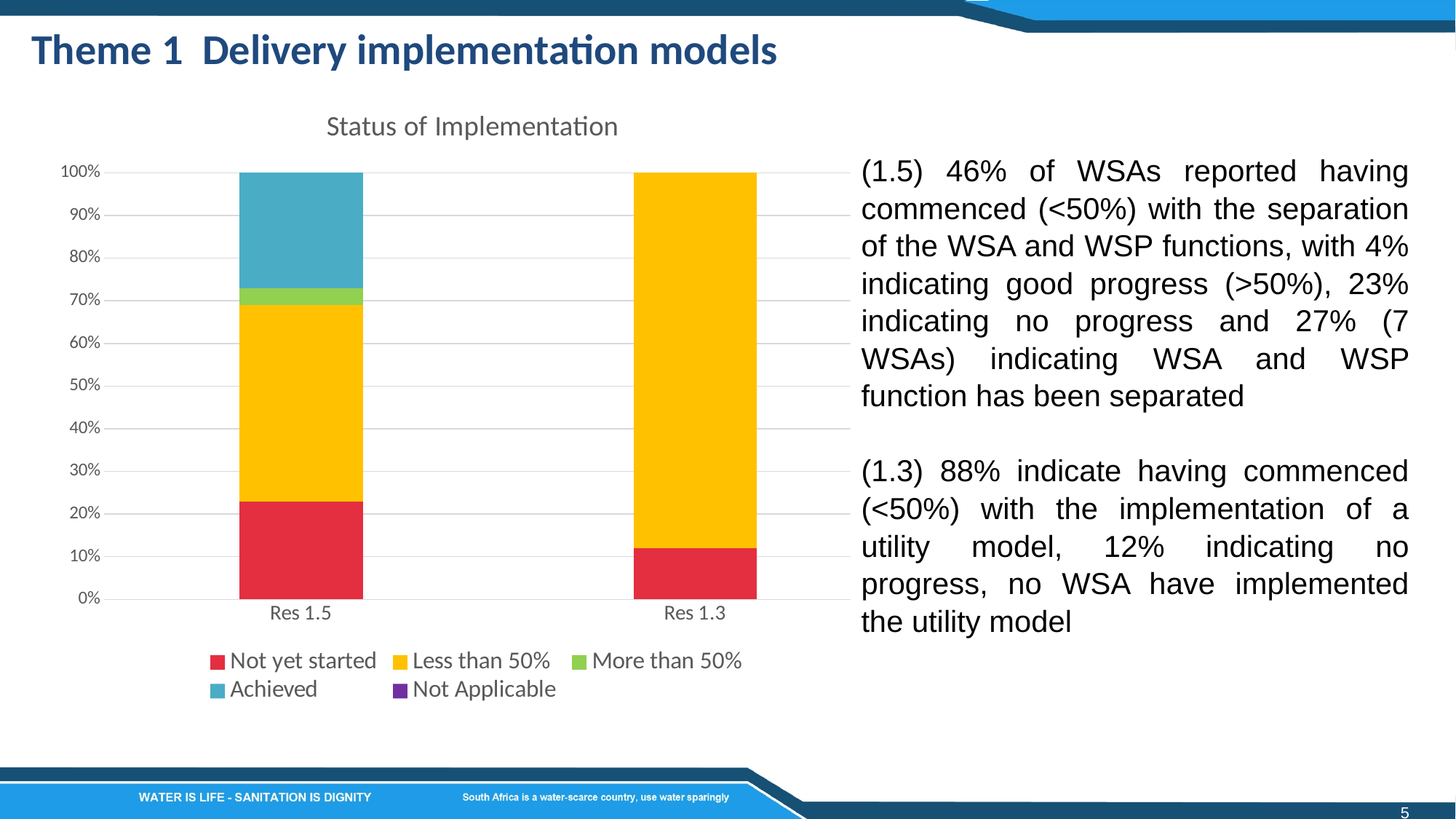
What is the total height of the stacked bar for Res 1.5? 100% What is the title of the chart? Status of Implementation Which category shows an 'Achieved' segment in its bar? Res 1.5 Is the 'Not yet started' value for Res 1.5 greater or less than 20%? greater How many categories are shown on the x axis of the chart? 2 Which category has the larger 'Not yet started' share, Res 1.5 or Res 1.3? Res 1.5 Is the 'Less than 50%' value for Res 1.3 greater or less than 80%? greater What type of chart is shown on the slide? Stacked bar chart How many series does the chart legend list? 5 Which category has the larger 'Less than 50%' share, Res 1.5 or Res 1.3? Res 1.3 Is the 'Less than 50%' value for Res 1.5 greater or less than 50%? less